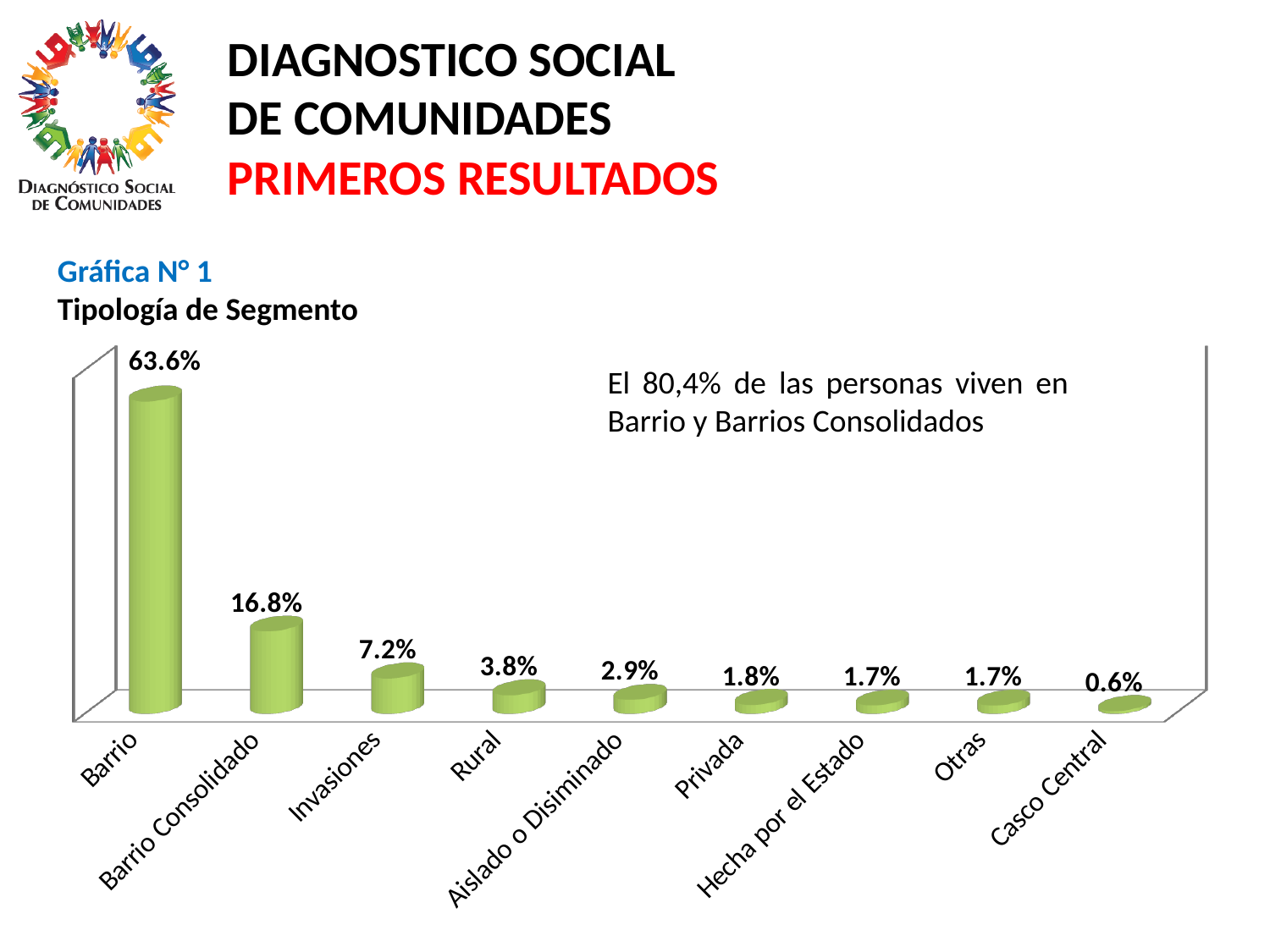
Which is larger, the value for Rural or the value for Privada? Rural Which category has the highest value? Barrio How many categories are shown in the chart? 9 What kind of chart is shown on the slide? Bar chart Which category has the lowest value? Casco Central What is the value for Barrio? 63.6% What is the value for Casco Central? 0.6% What is the value for Invasiones? 7.2% What is the value for Barrio Consolidado? 16.8% What is the title of the chart? Tipología de Segmento What is the value for Aislado o Disiminado? 2.9% What is the difference between the values for Barrio and Barrio Consolidado? 46.8%